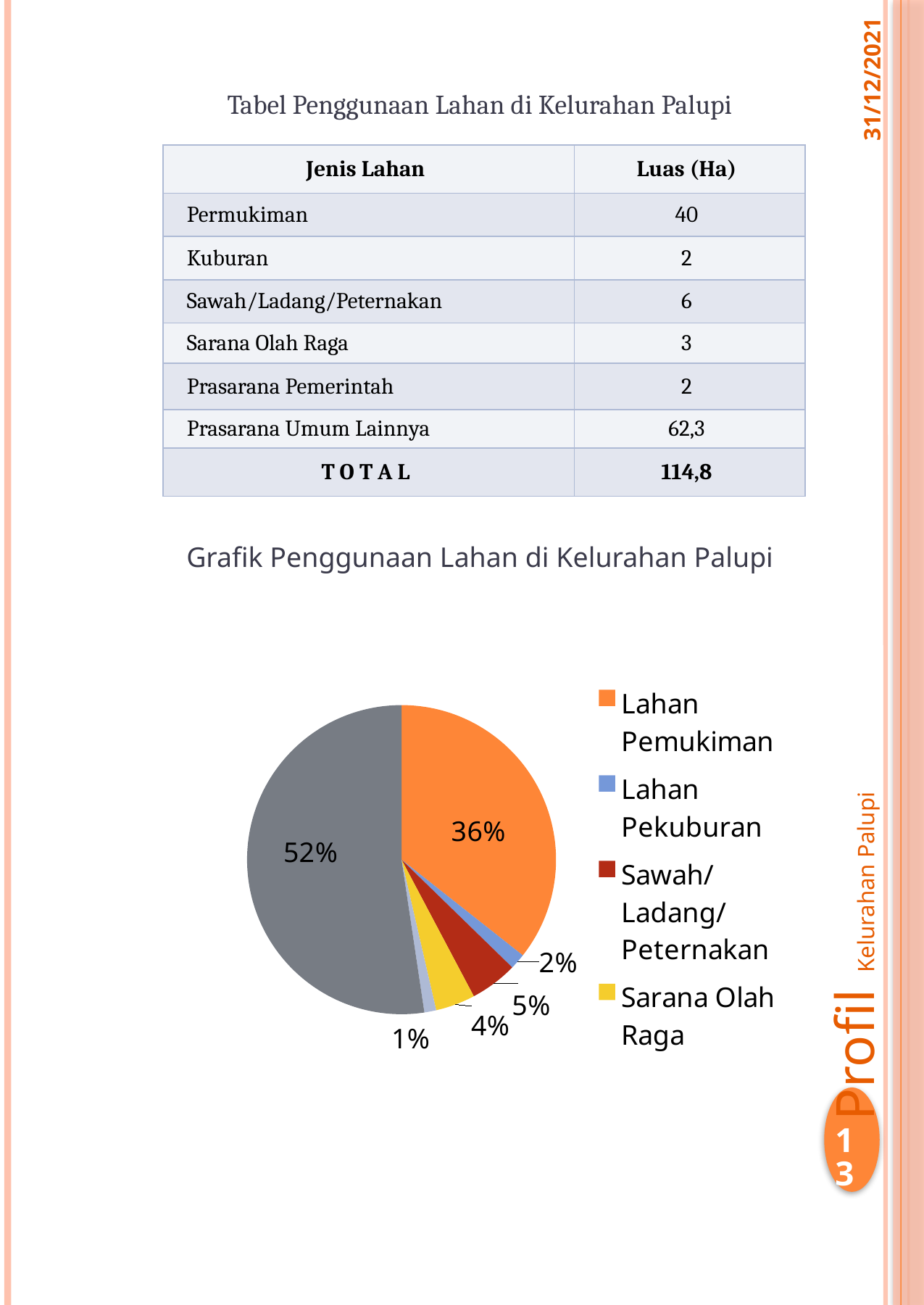
In the pie chart, what is the difference in percentage points between Lahan Pemukiman and Sawah/Ladang/Peternakan? 31 What is the smallest percentage label shown on the pie chart? 1% In the pie chart, what percentage is shown for Lahan Pemukiman? 36% In the pie chart, what percentage is shown for Sarana Olah Raga? 4% What type of chart is shown under the title 'Grafik Penggunaan Lahan di Kelurahan Palupi'? pie chart What is the title of the pie chart on the slide? Grafik Penggunaan Lahan di Kelurahan Palupi In the pie chart, which has a larger share: Sawah/Ladang/Peternakan or Sarana Olah Raga? Sawah/Ladang/Peternakan What colour is the Lahan Pemukiman slice in the pie chart? orange In the pie chart, what percentage is shown for Lahan Pekuburan? 2% In the pie chart, what percentage is shown for Sawah/Ladang/Peternakan? 5% How many slices does the pie chart have? 6 What is the largest percentage label shown on the pie chart? 52%